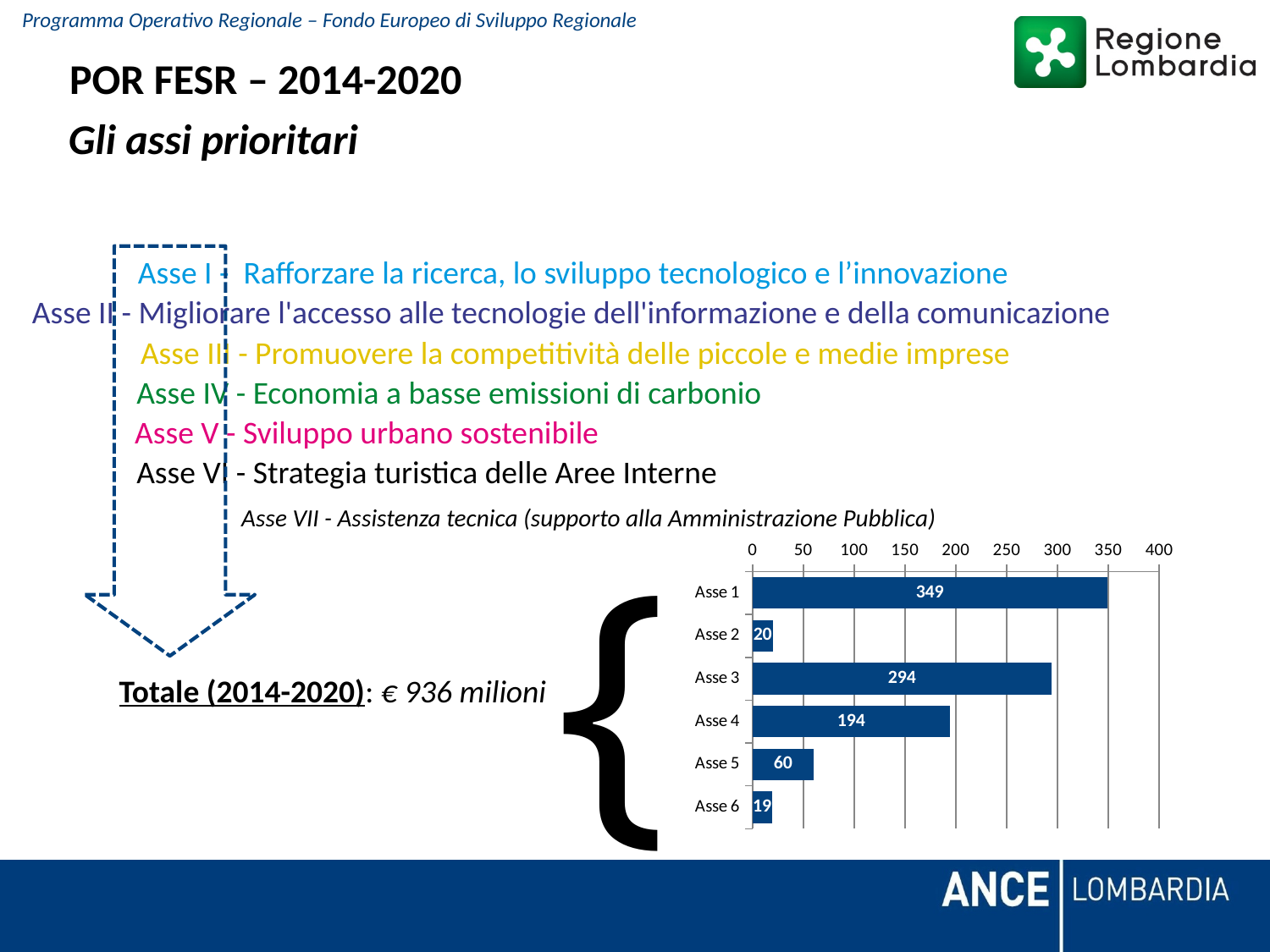
What is the maximum value shown on the chart's value axis? 400 Which category has the highest value in the bar chart? Asse 1 What is the difference between the values for Asse 1 and Asse 3? 55 What kind of chart is shown on the slide? bar chart Which is larger, the value for Asse 2 or the value for Asse 5? Asse 5 What is the value for Asse 5 in the bar chart? 60 What is the value for Asse 1 in the bar chart? 349 Is the value for Asse 4 greater or less than 150? greater What is the difference between the values for Asse 4 and Asse 5? 134 Which category has the lowest value in the bar chart? Asse 6 What is the value for Asse 3 in the bar chart? 294 How many categories are shown in the bar chart? 6